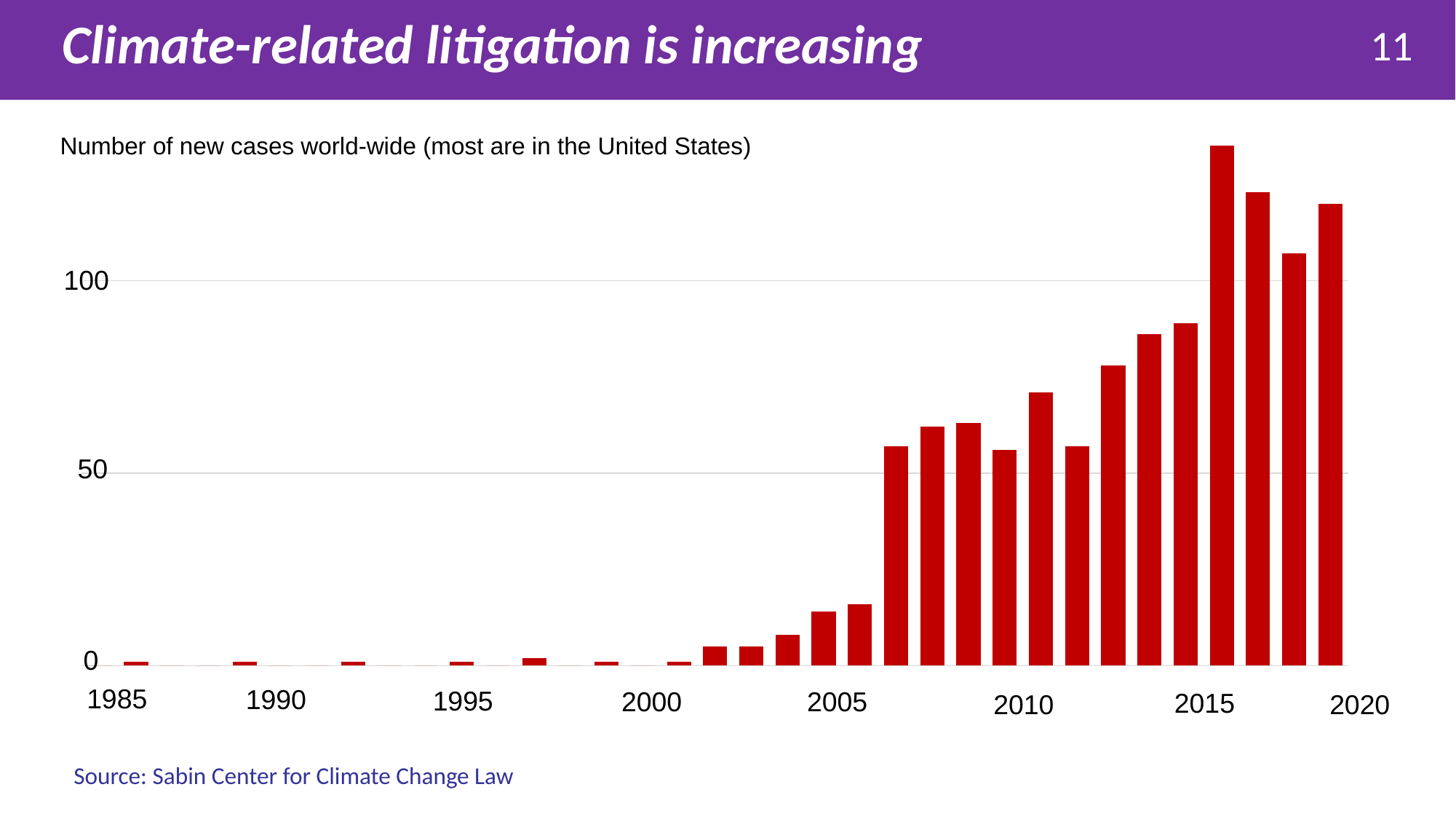
What kind of chart is shown on the slide? bar chart Is the tallest bar in the chart greater or less than 100? greater Which has the larger value, 2000 or 2010? 2010 Is the value for 2010 greater or less than 50? greater What does the chart's subtitle say is being plotted? Number of new cases world-wide (most are in the United States) Is the value for 2010 greater or less than 100? less Do the values generally rise or fall from 1985 to 2020 along the x axis? rise What is the title of the slide containing the chart? Climate-related litigation is increasing